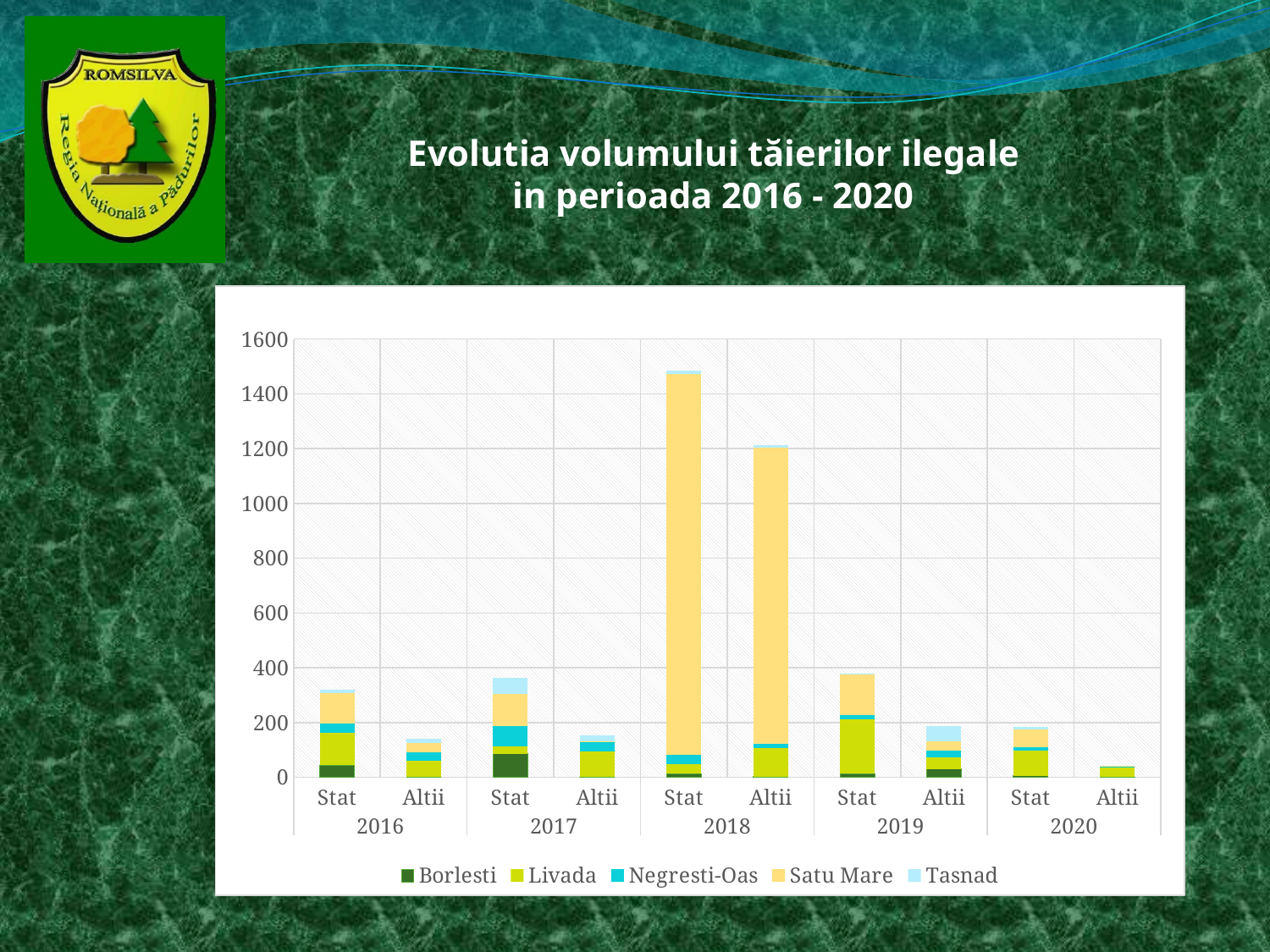
Which bar is the tallest in the chart? Stat 2018 How many series does the legend list? 5 Which bar is taller, Stat 2019 or Altii 2019? Stat 2019 Which series is shown in the lightest yellow colour in the legend? Satu Mare Is the total value for Stat in 2016 greater or less than 200? greater Which bar is taller, Stat 2018 or Altii 2018? Stat 2018 What kind of chart is shown on the slide? stacked bar chart Is the total value for Altii in 2018 greater or less than 1000? greater Which bar is the shortest in the chart? Altii 2020 Is the total value for Altii in 2016 greater or less than 200? less How many bars are plotted in the chart? 10